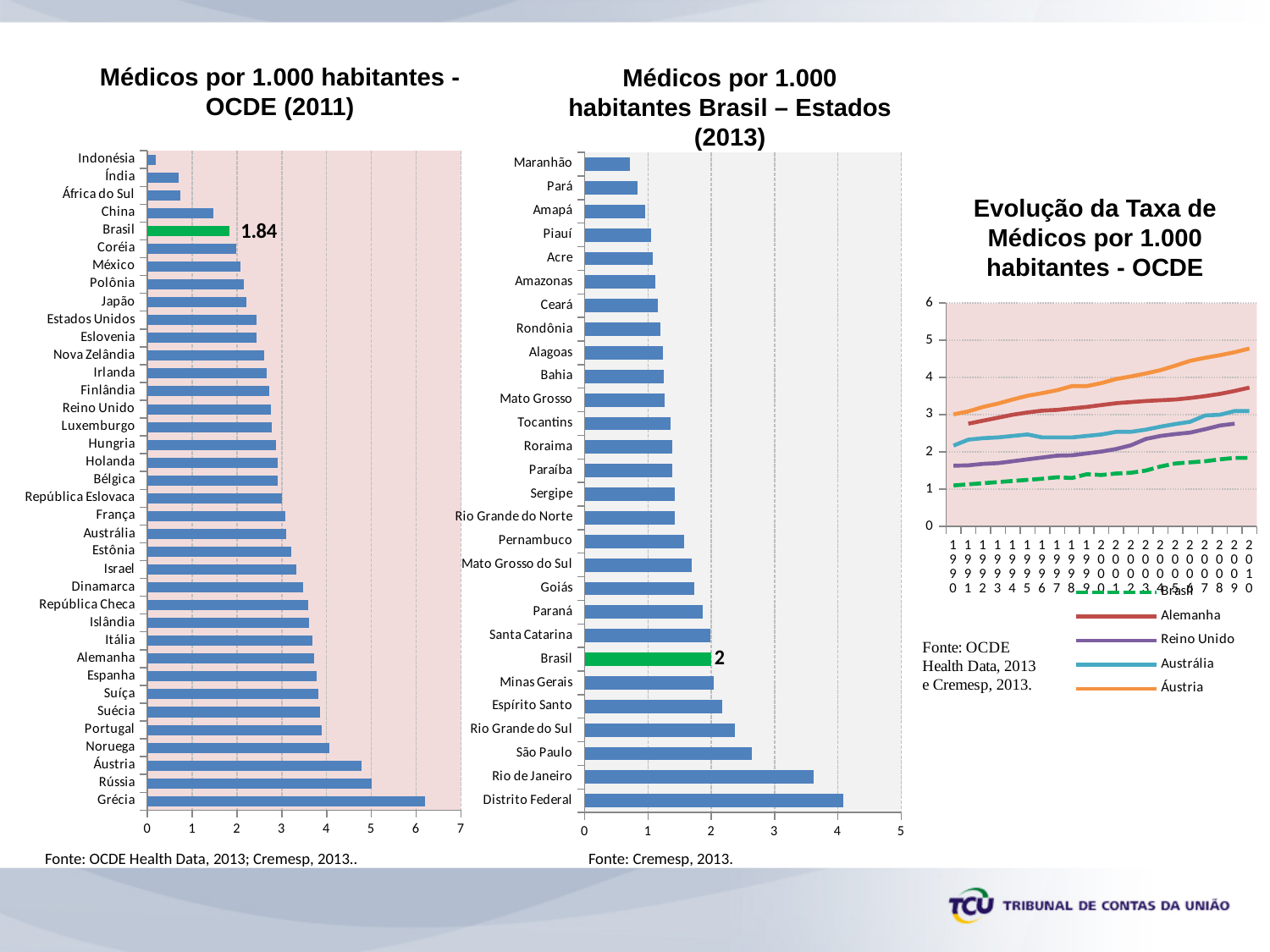
How many series does the legend of the chart 'Evolução da Taxa de Médicos por 1.000 habitantes - OCDE' list? 5 In the chart 'Médicos por 1.000 habitantes - OCDE (2011)', which country has the highest value? Grécia In the chart 'Médicos por 1.000 habitantes Brasil – Estados (2013)', which state has the lowest value? Maranhão What kind of chart is 'Médicos por 1.000 habitantes Brasil – Estados (2013)'? bar chart In the chart 'Médicos por 1.000 habitantes - OCDE (2011)', what is the value for Brasil? 1.84 In the chart 'Médicos por 1.000 habitantes Brasil – Estados (2013)', is the value for Rio de Janeiro greater or less than 3? greater In the chart 'Médicos por 1.000 habitantes Brasil – Estados (2013)', what is the value for Brasil? 2 In the chart 'Médicos por 1.000 habitantes - OCDE (2011)', is the value for Áustria greater or less than 5? less In the chart 'Evolução da Taxa de Médicos por 1.000 habitantes - OCDE', does the Brasil line rise or fall from 1990 to 2010? rise In the chart 'Médicos por 1.000 habitantes Brasil – Estados (2013)', which category has the highest value? Distrito Federal In the chart 'Médicos por 1.000 habitantes Brasil – Estados (2013)', which is larger, the value for Rio de Janeiro or the value for São Paulo? Rio de Janeiro In the chart 'Médicos por 1.000 habitantes - OCDE (2011)', which country has the lowest value? Indonésia